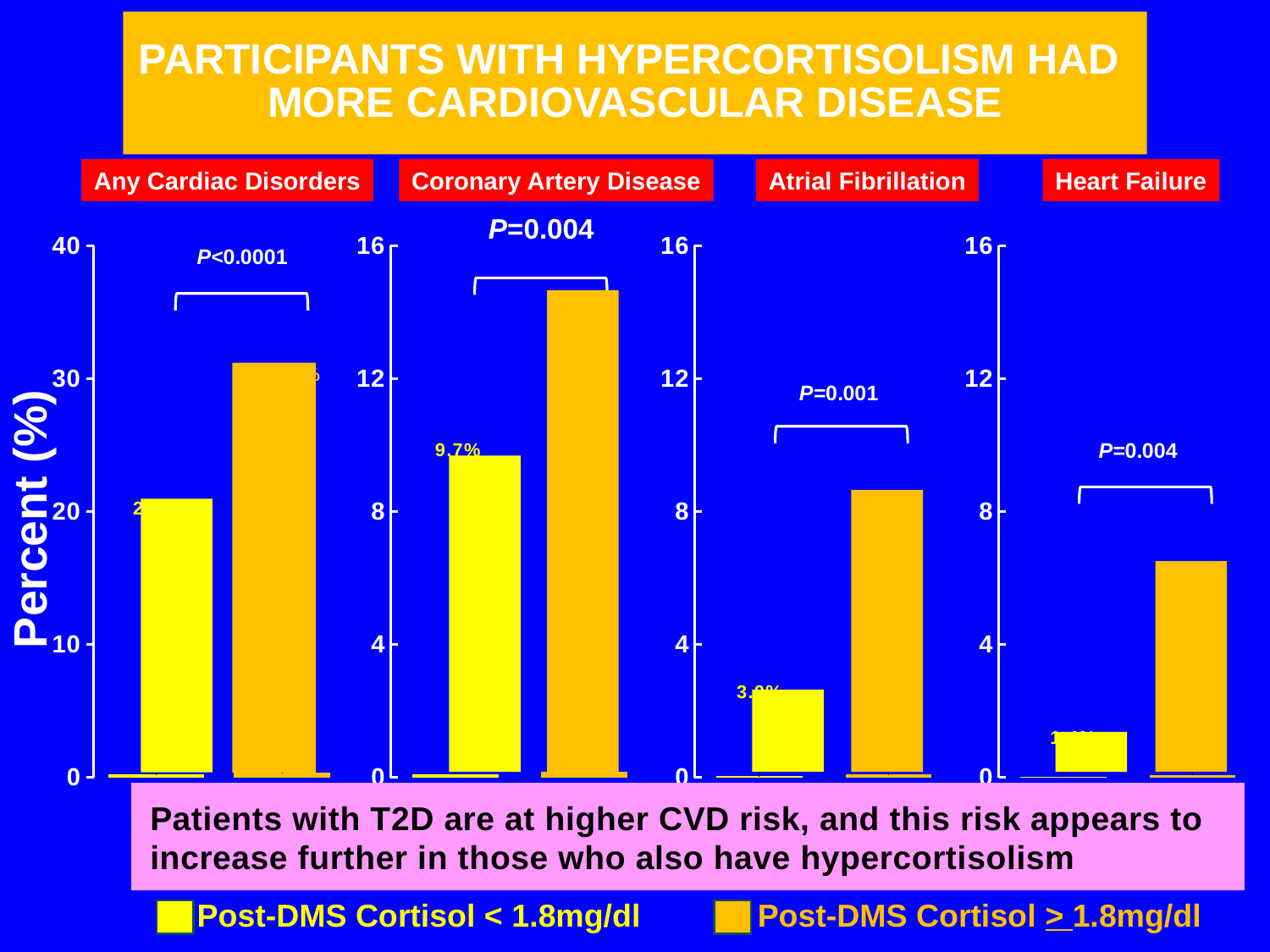
What P value is shown above the bars in the Atrial Fibrillation chart? P=0.001 In the Coronary Artery Disease chart, is the value for the Post-DMS Cortisol > 1.8mg/dl group greater or less than 12? greater In the Atrial Fibrillation chart, is the value for the Post-DMS Cortisol < 1.8mg/dl group greater or less than 4? less In the Coronary Artery Disease chart, what is the value for the Post-DMS Cortisol < 1.8mg/dl group? 9.7% What kind of chart is used for the Any Cardiac Disorders panel? bar chart In the Heart Failure chart, is the value for the Post-DMS Cortisol > 1.8mg/dl group greater or less than 8? less How many series does the legend at the bottom of the slide list? 2 In the Heart Failure chart, which group has the higher value, Post-DMS Cortisol < 1.8mg/dl or Post-DMS Cortisol > 1.8mg/dl? Post-DMS Cortisol > 1.8mg/dl In the Atrial Fibrillation chart, which group has the lower value? Post-DMS Cortisol < 1.8mg/dl How many bars are shown in the Coronary Artery Disease chart? 2